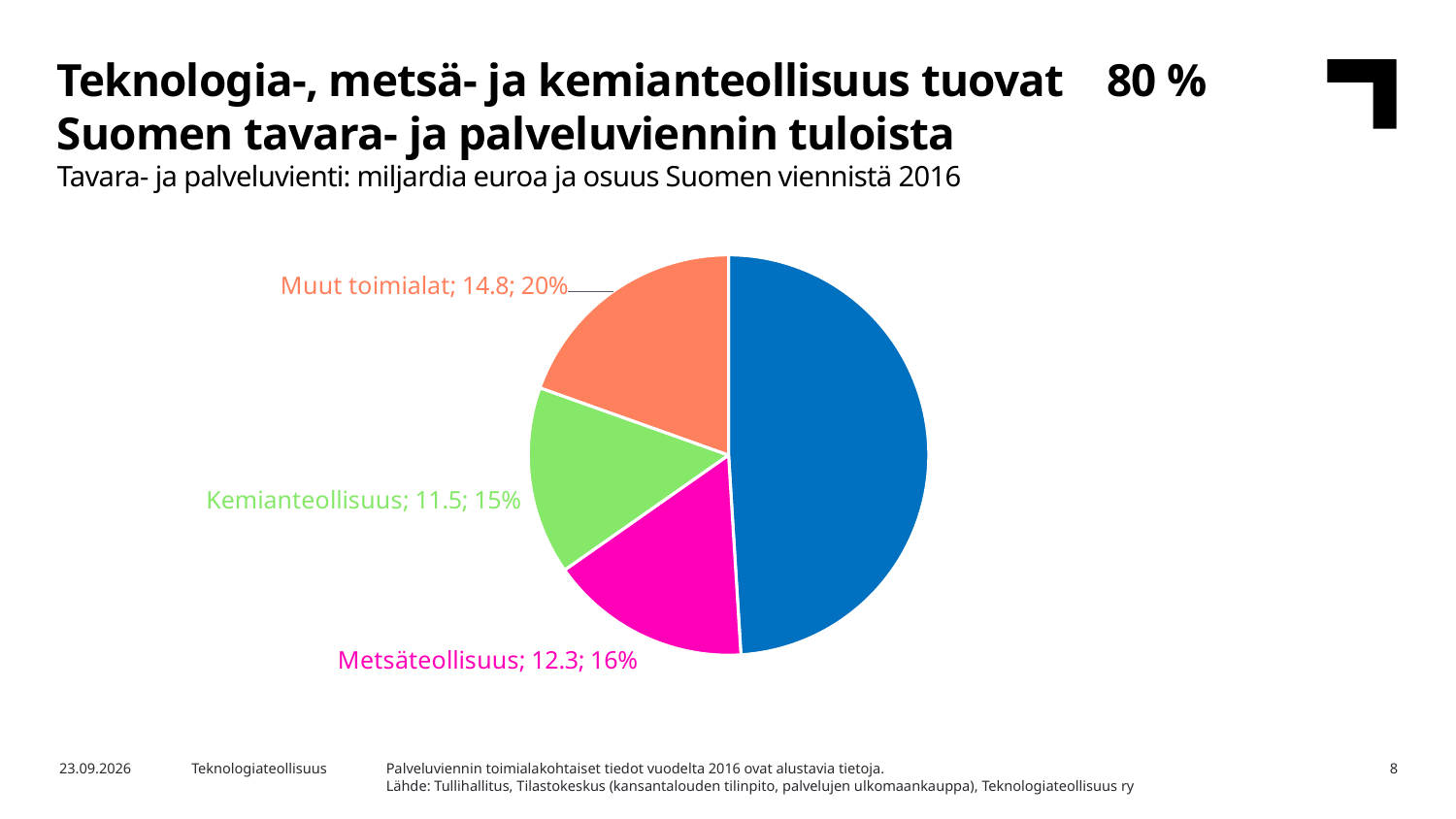
What is the difference between the values for Muut toimialat and Kemianteollisuus? 3.3 What share of the pie does Muut toimialat represent? 20% Which is larger, the value for Muut toimialat or the value for Metsäteollisuus? Muut toimialat What kind of chart is shown on the slide? Pie chart What value in billions of euros is shown for Metsäteollisuus? 12.3 What value in billions of euros is shown for Kemianteollisuus? 11.5 How many slices does the pie chart have? 4 What value in billions of euros is shown for Muut toimialat? 14.8 What share of the pie does Metsäteollisuus represent? 16% What colour is the Metsäteollisuus slice? Magenta (pink) What is the difference between the values for Metsäteollisuus and Kemianteollisuus? 0.8 Which category has the smallest slice of the pie? Kemianteollisuus